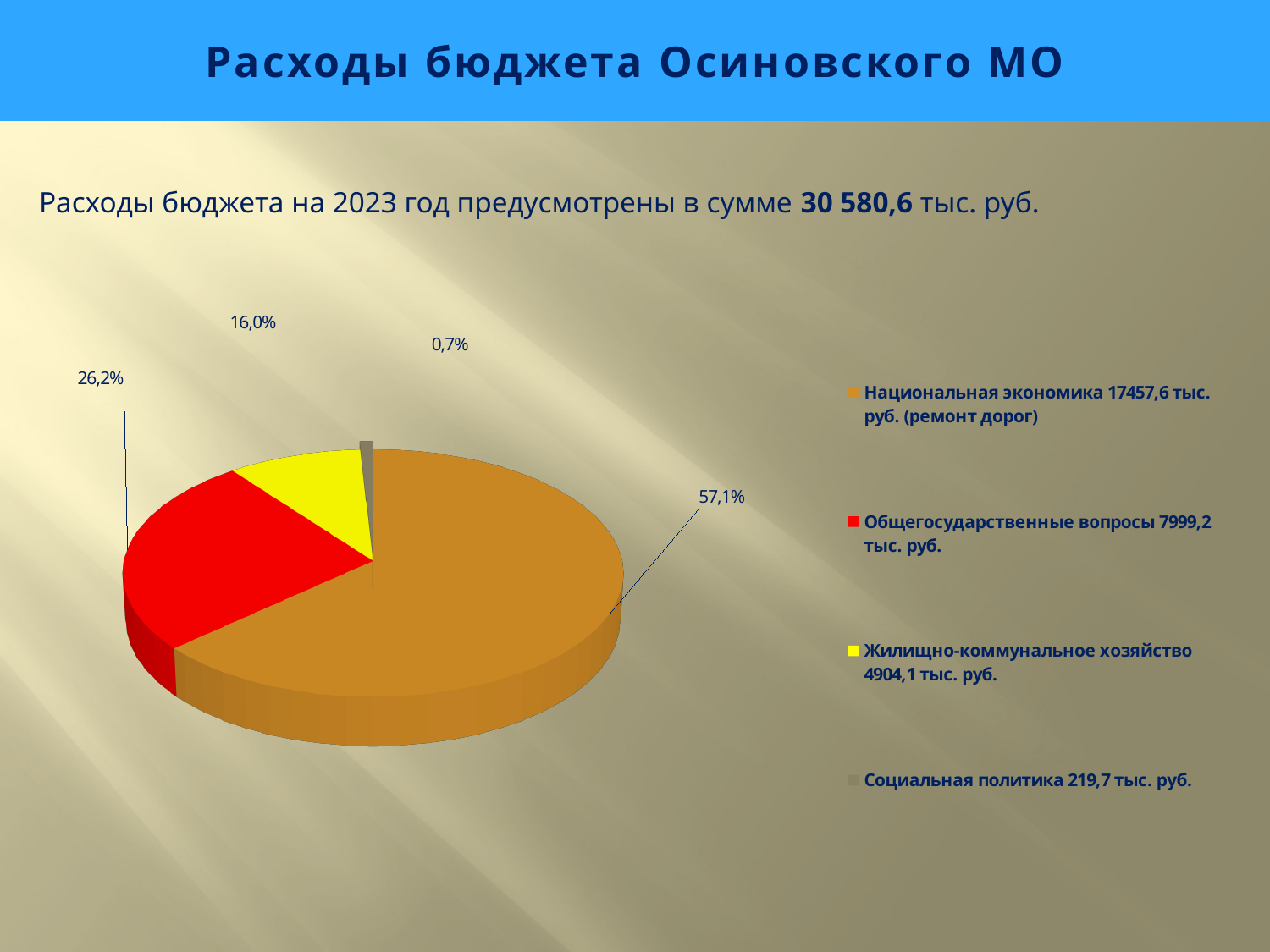
What share of the pie does Национальная экономика (ремонт дорог) take? 57,1% How many slices does the pie chart have? 4 What amount in тыс. руб. is shown in the legend for Жилищно-коммунальное хозяйство? 4904,1 тыс. руб. How many entries does the legend list? 4 What is the difference in percentage points between the Национальная экономика slice and the Общегосударственные вопросы slice? 30,9% Which category has the smallest slice of the pie? Социальная политика What share of the pie does Жилищно-коммунальное хозяйство take? 16,0% What share of the pie does Социальная политика take? 0,7% Which category has the largest slice of the pie? Национальная экономика (ремонт дорог) What kind of chart is shown on the slide? pie chart Which slice is larger: Общегосударственные вопросы or Жилищно-коммунальное хозяйство? Общегосударственные вопросы